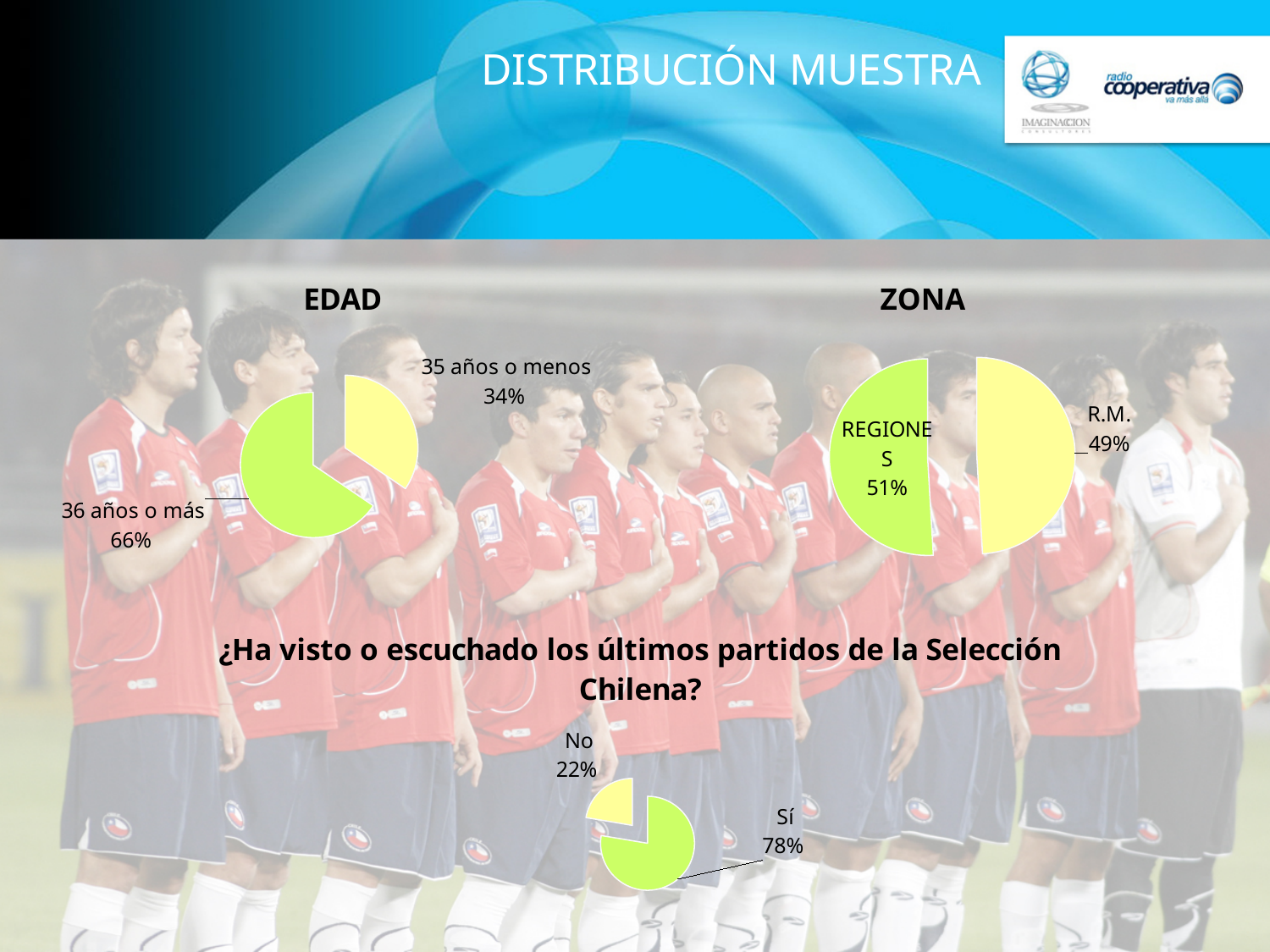
In the EDAD chart, what share of the sample is 36 años o más? 66% In the chart titled '¿Ha visto o escuchado los últimos partidos de la Selección Chilena?', which answer has the smaller share? No In the EDAD chart, which age group has the larger share? 36 años o más How many charts are shown on the slide? 3 In the ZONA chart, how many slices does the pie have? 2 In the ZONA chart, what share of the sample is from REGIONES? 51% In the chart titled '¿Ha visto o escuchado los últimos partidos de la Selección Chilena?', what share answered Sí? 78% In the ZONA chart, what share of the sample is from R.M.? 49% In the EDAD chart, what share of the sample is 35 años o menos? 34% What type of chart is the EDAD chart? Pie chart In the chart titled '¿Ha visto o escuchado los últimos partidos de la Selección Chilena?', what share answered No? 22% In the EDAD chart, what is the difference in percentage points between 36 años o más and 35 años o menos? 32 percentage points